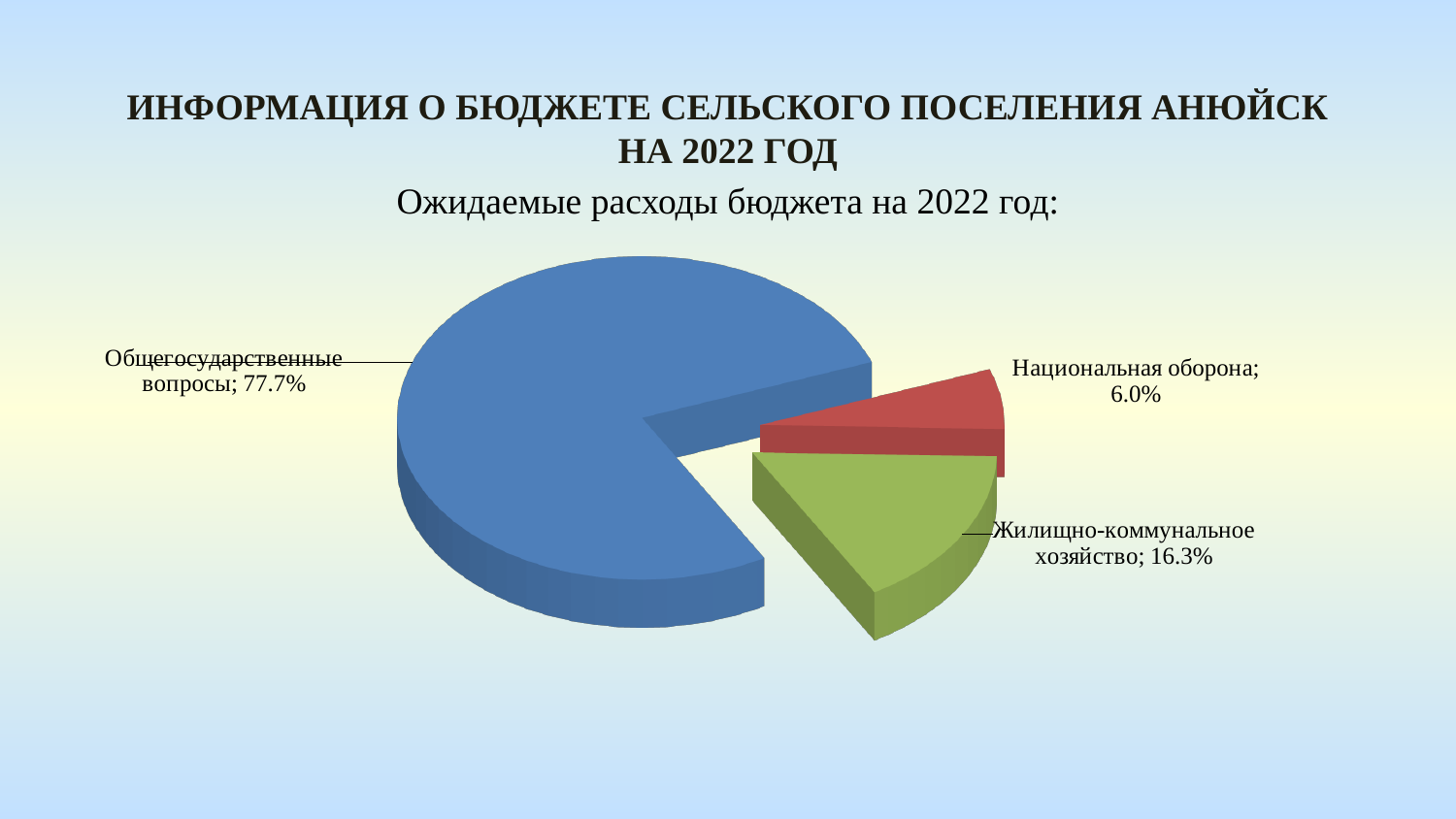
Which category has the largest share of the pie? Общегосударственные вопросы What kind of chart is shown on the slide? Pie chart What is the subtitle above the chart? Ожидаемые расходы бюджета на 2022 год: How many categories are shown in the pie chart? 3 What share of the pie does Жилищно-коммунальное хозяйство represent? 16.3% What is the difference in percentage points between Общегосударственные вопросы and Жилищно-коммунальное хозяйство? 61.4 What share of the pie does Национальная оборона represent? 6.0% Which category has the smallest share of the pie? Национальная оборона What is the difference in percentage points between Жилищно-коммунальное хозяйство and Национальная оборона? 10.3 What colour is the slice for Национальная оборона? Red What share of the pie does Общегосударственные вопросы represent? 77.7% Which is larger: the share for Жилищно-коммунальное хозяйство or the share for Национальная оборона? Жилищно-коммунальное хозяйство